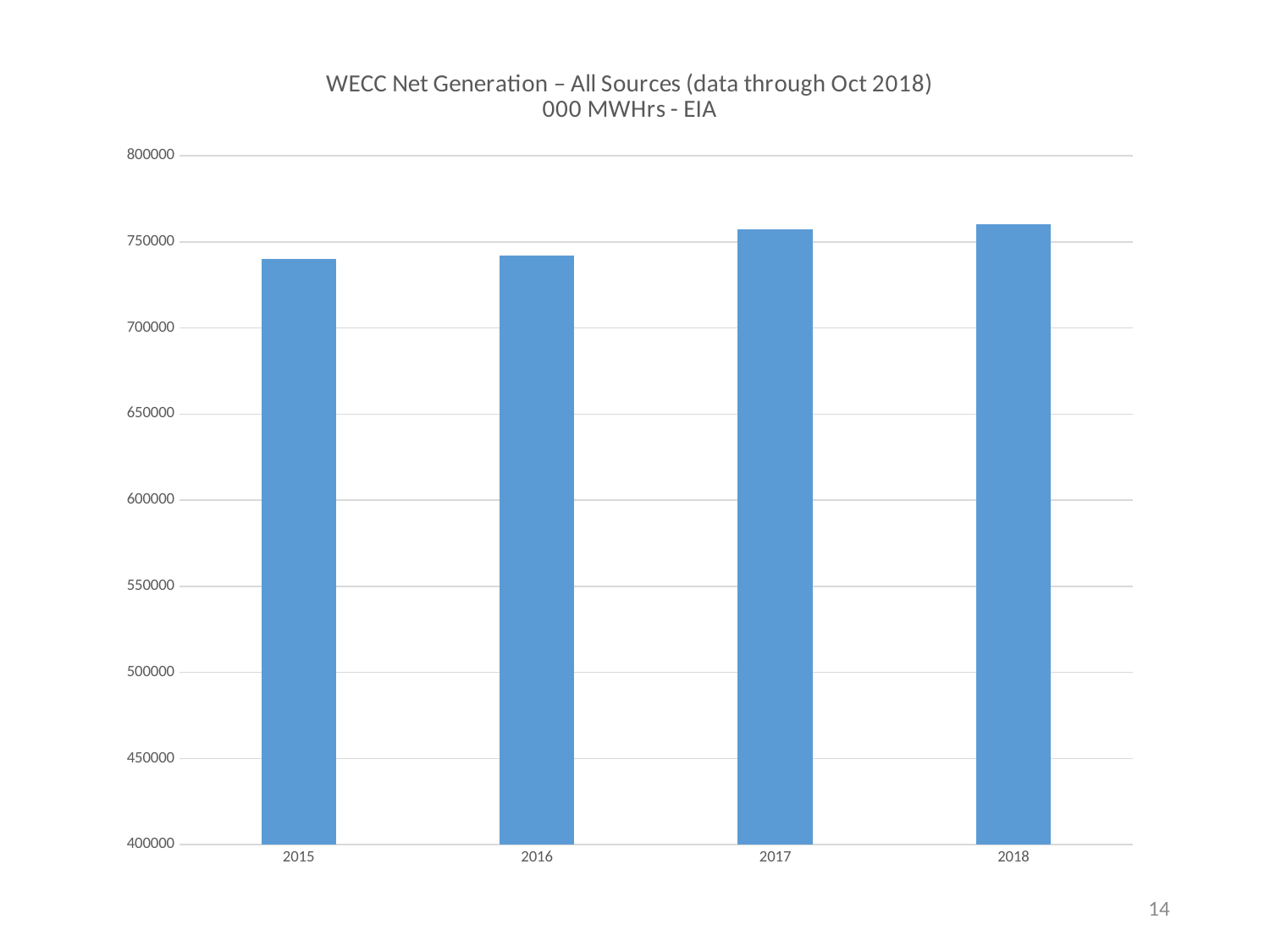
Is the value for 2017 greater or less than 750000? greater Is the value for 2018 greater or less than 750000? greater Which is larger, the value for 2015 or the value for 2017? 2017 Do the values generally rise or fall from 2015 to 2018? Rise What is the title of the chart? WECC Net Generation – All Sources (data through Oct 2018) 000 MWHrs - EIA Is the value for 2016 greater or less than 700000? greater What kind of chart is shown on the slide? Bar chart Which is larger, the value for 2016 or the value for 2018? 2018 What value does the vertical axis start at? 400000 How many years are plotted on the chart? 4